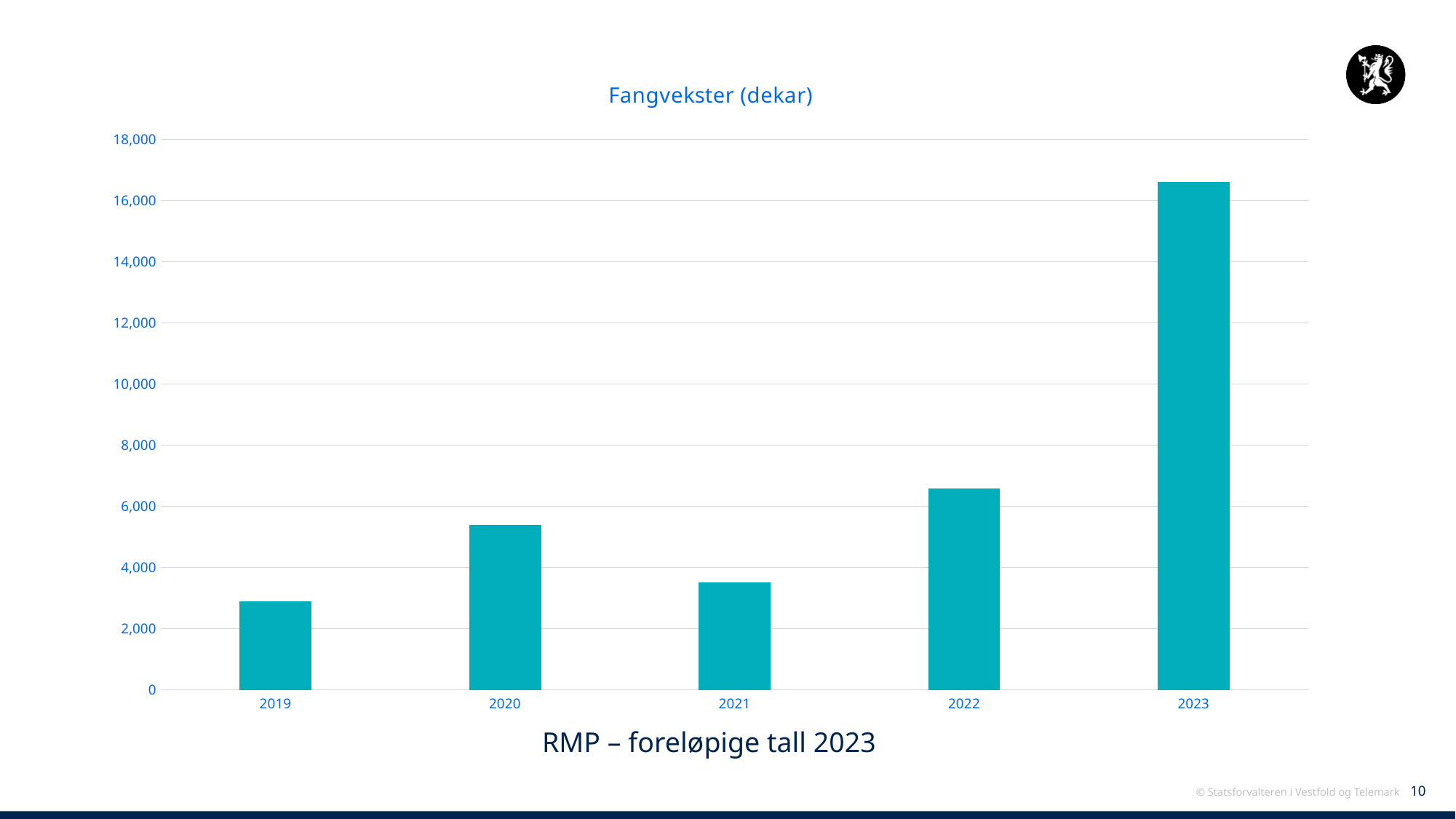
Which year has the larger value, 2020 or 2021? 2020 Is the value for 2022 greater or less than 6,000? greater Which year has the highest value in the chart? 2023 What kind of chart is shown on the slide? bar chart Which year has the larger value, 2022 or 2020? 2022 Is the value for 2019 greater or less than 4,000? less What is the title of the chart? Fangvekster (dekar) Is the value for 2021 greater or less than 4,000? less Which year has the lowest value in the chart? 2019 How many years are shown on the x axis of the chart? 5